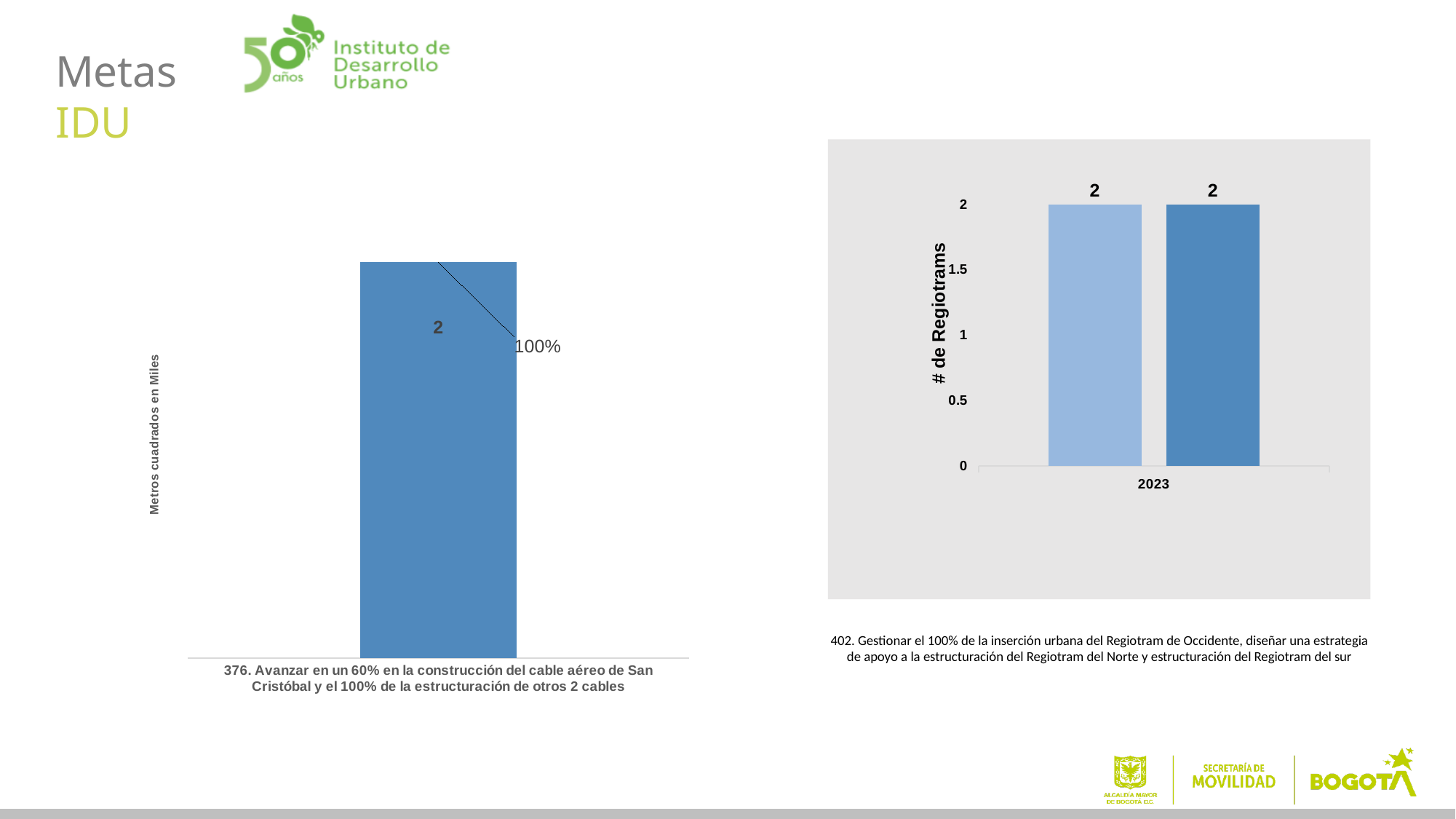
On the right chart, what is the value of the light blue bar for 2023? 2 What kind of chart is the right chart? bar chart On the right chart, what is the value of the dark blue bar for 2023? 2 On the left chart, what value is printed on the bar for meta 376? 2 On the left chart, what is the y-axis title? Metros cuadrados en Miles On the left chart, what percentage is shown next to the bar? 100% On the right chart, is the value of the dark blue bar greater or less than 1? greater What kind of chart is the left chart? bar chart On the left chart, how many bars are plotted? 1 On the right chart, what is the difference between the light blue bar and the dark blue bar? 0 On the right chart, what is the y-axis title? # de Regiotrams On the right chart, how many bars are plotted for 2023? 2